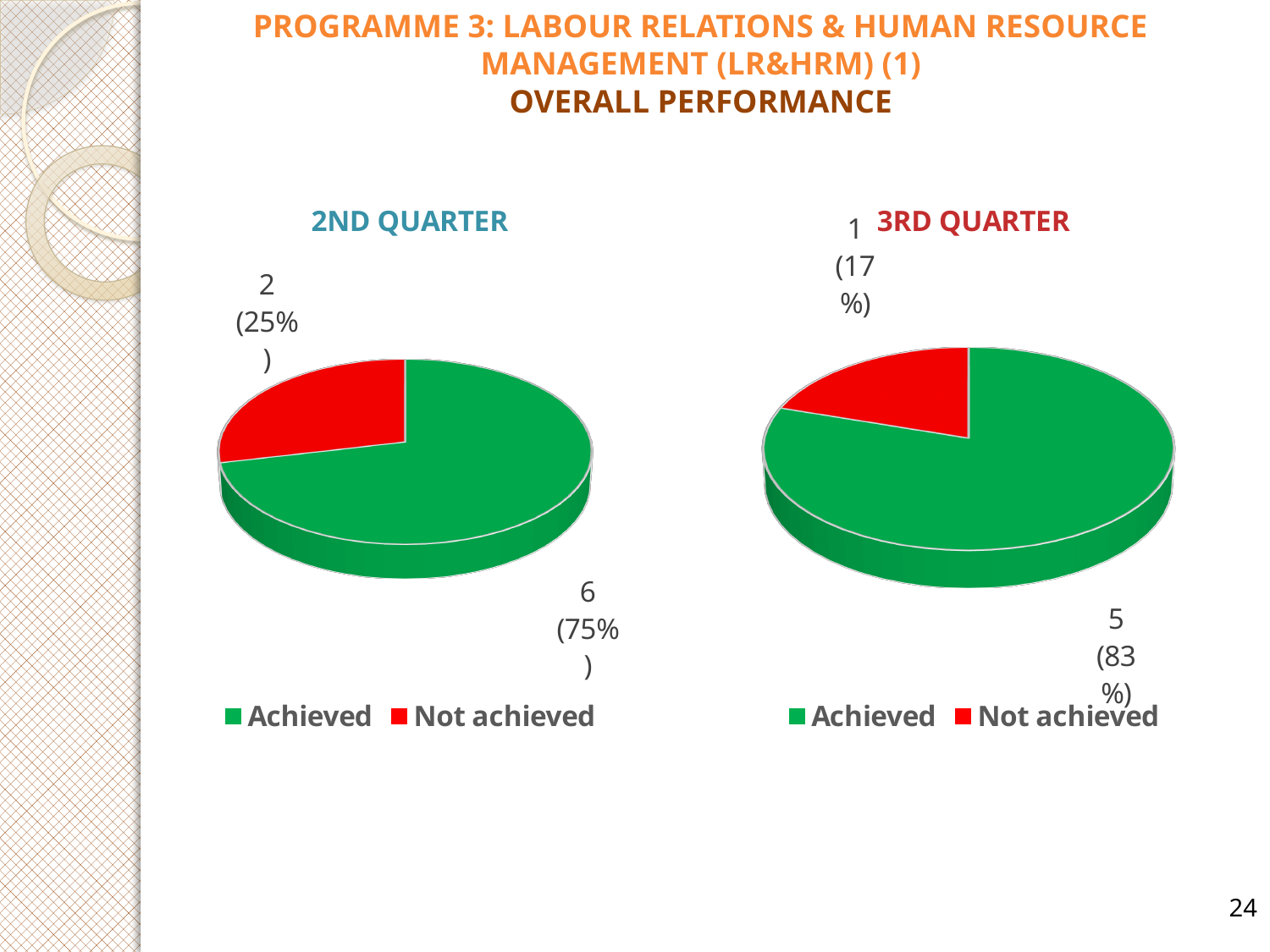
In the 3RD QUARTER chart, which slice is the largest? Achieved In the 3RD QUARTER chart, what share of the pie is Not achieved? 17% In the 2ND QUARTER chart, what share of the pie is Achieved? 75% In the 3RD QUARTER chart, how many targets were Achieved? 5 In the 3RD QUARTER chart, how many targets were Not achieved? 1 In the 3RD QUARTER chart, what colour represents Not achieved? Red In the 2ND QUARTER chart, how many targets were Achieved? 6 What type of chart is used for the 3RD QUARTER? Pie chart In the 2ND QUARTER chart, what is the difference between the Achieved and Not achieved counts? 4 In the 2ND QUARTER chart, how many targets were Not achieved? 2 How many entries does the legend of the 2ND QUARTER chart list? 2 In the 2ND QUARTER chart, which slice is the smallest? Not achieved